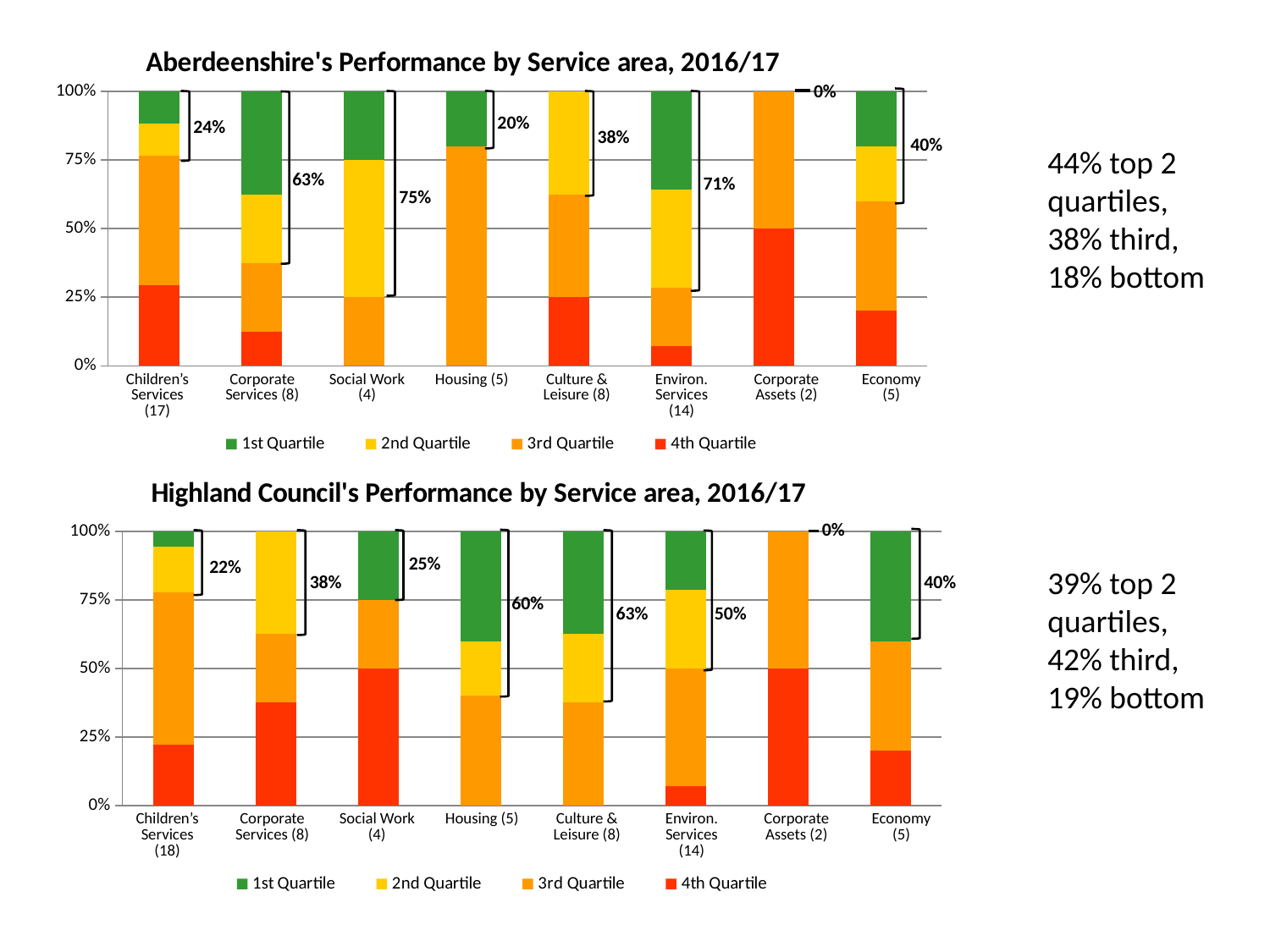
In the Aberdeenshire's Performance by Service area, 2016/17 chart, what is the difference between the labelled percentages for Environ. Services (14) and Children's Services (17)? 47% In the Highland Council's Performance by Service area, 2016/17 chart, what percentage label is shown for Housing (5)? 60% In the Aberdeenshire's Performance by Service area, 2016/17 chart, what percentage label is shown for Social Work (4)? 75% In the Highland Council's Performance by Service area, 2016/17 chart, which has the larger labelled percentage, Corporate Services (8) or Environ. Services (14)? Environ. Services (14) In the Aberdeenshire's Performance by Service area, 2016/17 chart, which service area has the highest labelled percentage? Social Work (4) How many service areas are shown on the x axis of the Highland Council's Performance by Service area, 2016/17 chart? 8 In the Highland Council's Performance by Service area, 2016/17 chart, which service area has the highest labelled percentage? Culture & Leisure (8) How many series does the legend of the Aberdeenshire's Performance by Service area, 2016/17 chart list? 4 Which colour represents the 1st Quartile in the legend of the Aberdeenshire's Performance by Service area, 2016/17 chart? Green In the Aberdeenshire's Performance by Service area, 2016/17 chart, is the 4th Quartile segment for Corporate Assets (2) greater or less than 25%? greater In the Highland Council's Performance by Service area, 2016/17 chart, what is the labelled percentage for Corporate Assets (2)? 0% What type of chart is the Highland Council's Performance by Service area, 2016/17 chart? Stacked bar chart